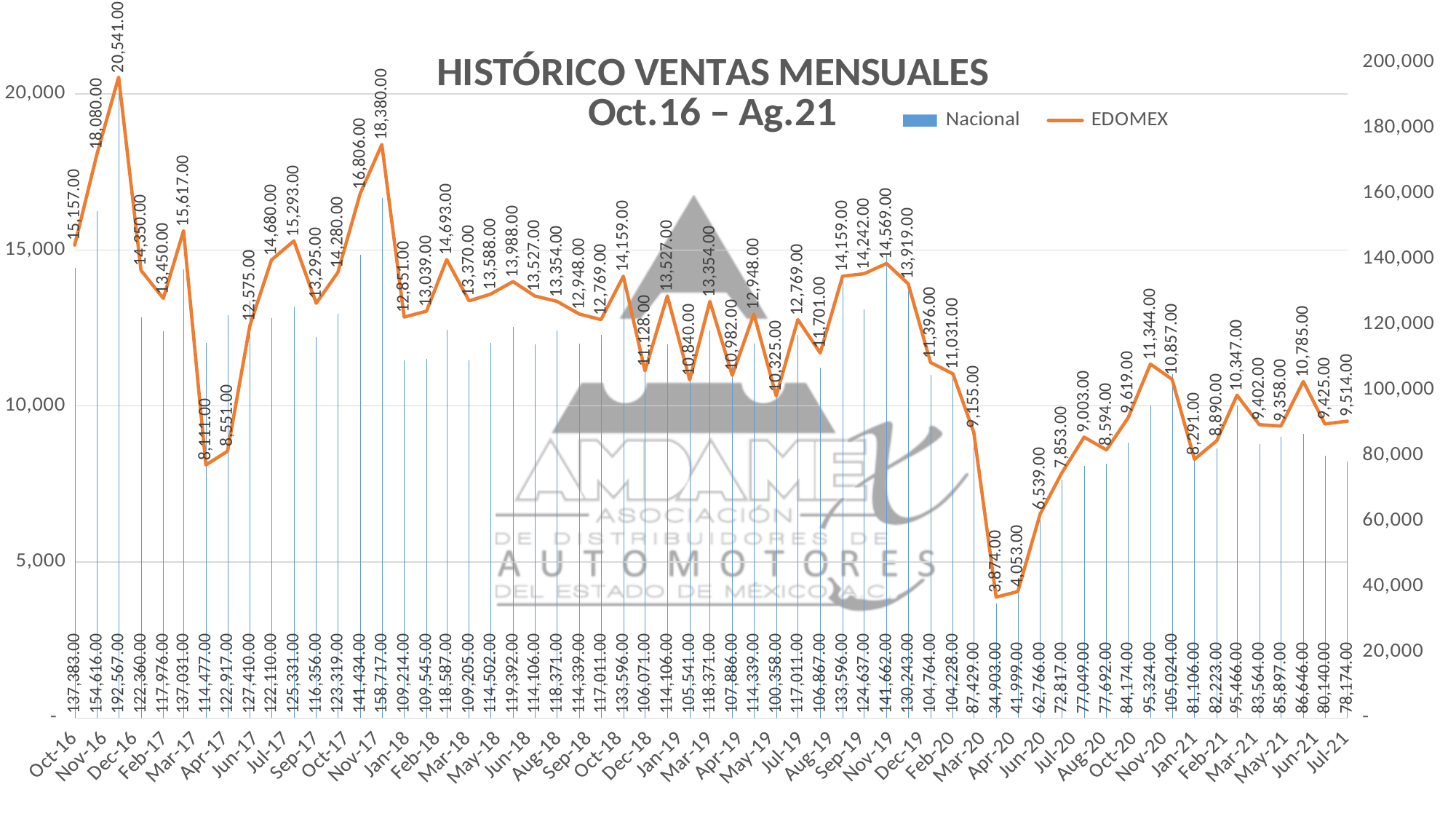
What kind of chart is shown on the slide? A combined bar and line chart What is the title of the chart? HISTÓRICO VENTAS MENSUALES Oct.16 – Ag.21 What is the highest value of the EDOMEX series? 20,541.00 How many series does the legend list? 2 Which series is drawn as an orange line? EDOMEX What is the difference between the highest and lowest EDOMEX values? 16,667.00 What is the lowest value of the EDOMEX series? 3,874.00 What is the highest value of the Nacional series? 192,567.00 Which is larger for the EDOMEX series: the first point (Oct-16) or the last point on the right? The first point (Oct-16) What is the EDOMEX value for Oct-16? 15,157.00 What is the Nacional value for Oct-16? 137,383.00 What is the lowest value of the Nacional series? 34,903.00